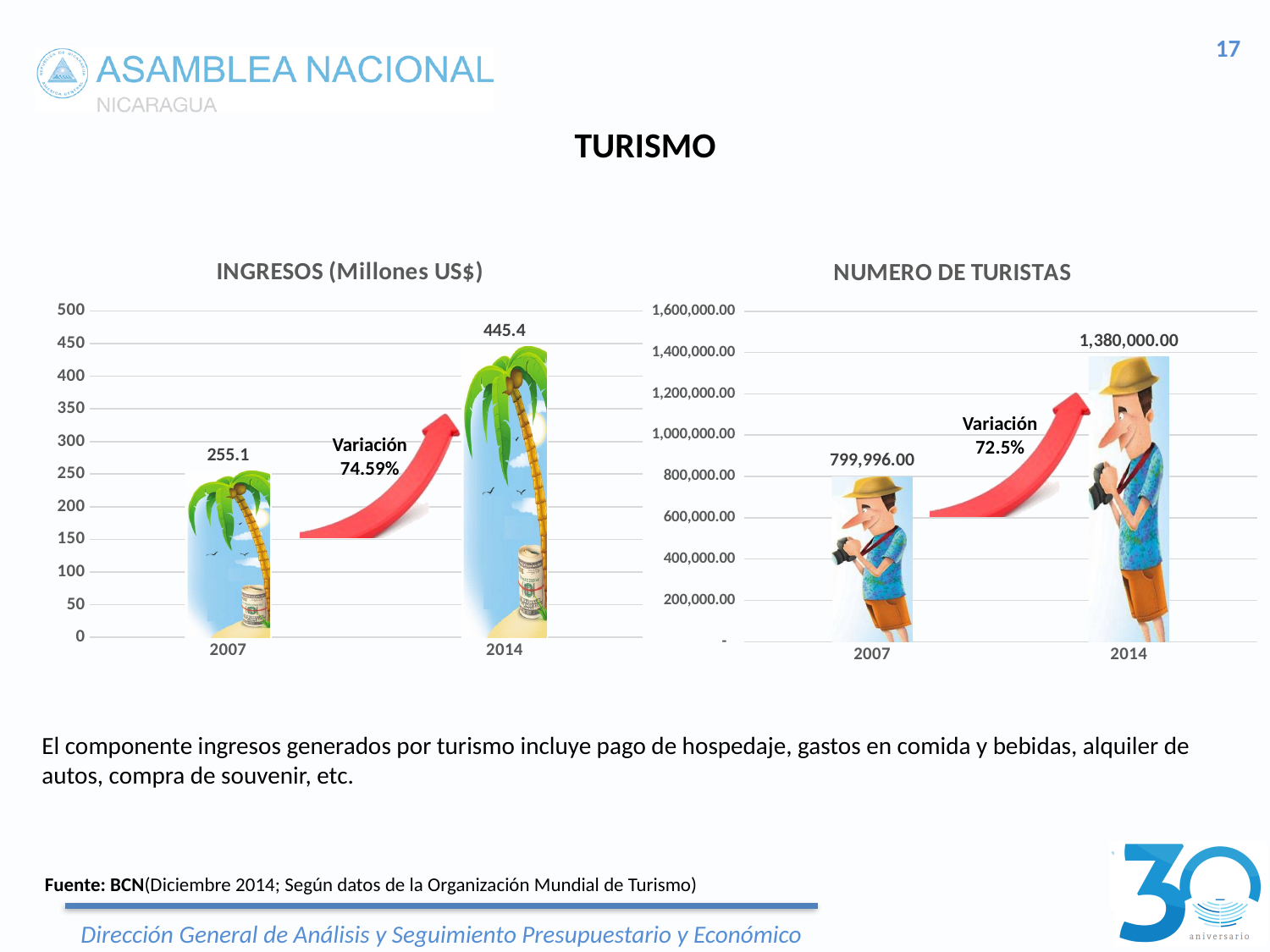
In the 'NUMERO DE TURISTAS' chart, which year has the lower value? 2007 In the 'NUMERO DE TURISTAS' chart, what is the value for 2007? 799,996.00 In the 'INGRESOS (Millones US$)' chart, what is the difference between the 2014 and 2007 values? 190.3 In the 'INGRESOS (Millones US$)' chart, what is the value for 2014? 445.4 In the 'NUMERO DE TURISTAS' chart, is the value for 2014 greater or less than 1,200,000.00? greater In the 'INGRESOS (Millones US$)' chart, do the values rise or fall from 2007 to 2014? rise In the 'NUMERO DE TURISTAS' chart, what percentage variation is labelled on the arrow? 72.5% In the 'NUMERO DE TURISTAS' chart, what is the value for 2014? 1,380,000.00 In the 'INGRESOS (Millones US$)' chart, what is the value for 2007? 255.1 In the 'INGRESOS (Millones US$)' chart, how many years are shown on the x axis? 2 What kind of chart is the 'NUMERO DE TURISTAS' chart? bar chart In the 'INGRESOS (Millones US$)' chart, which year has the higher value? 2014